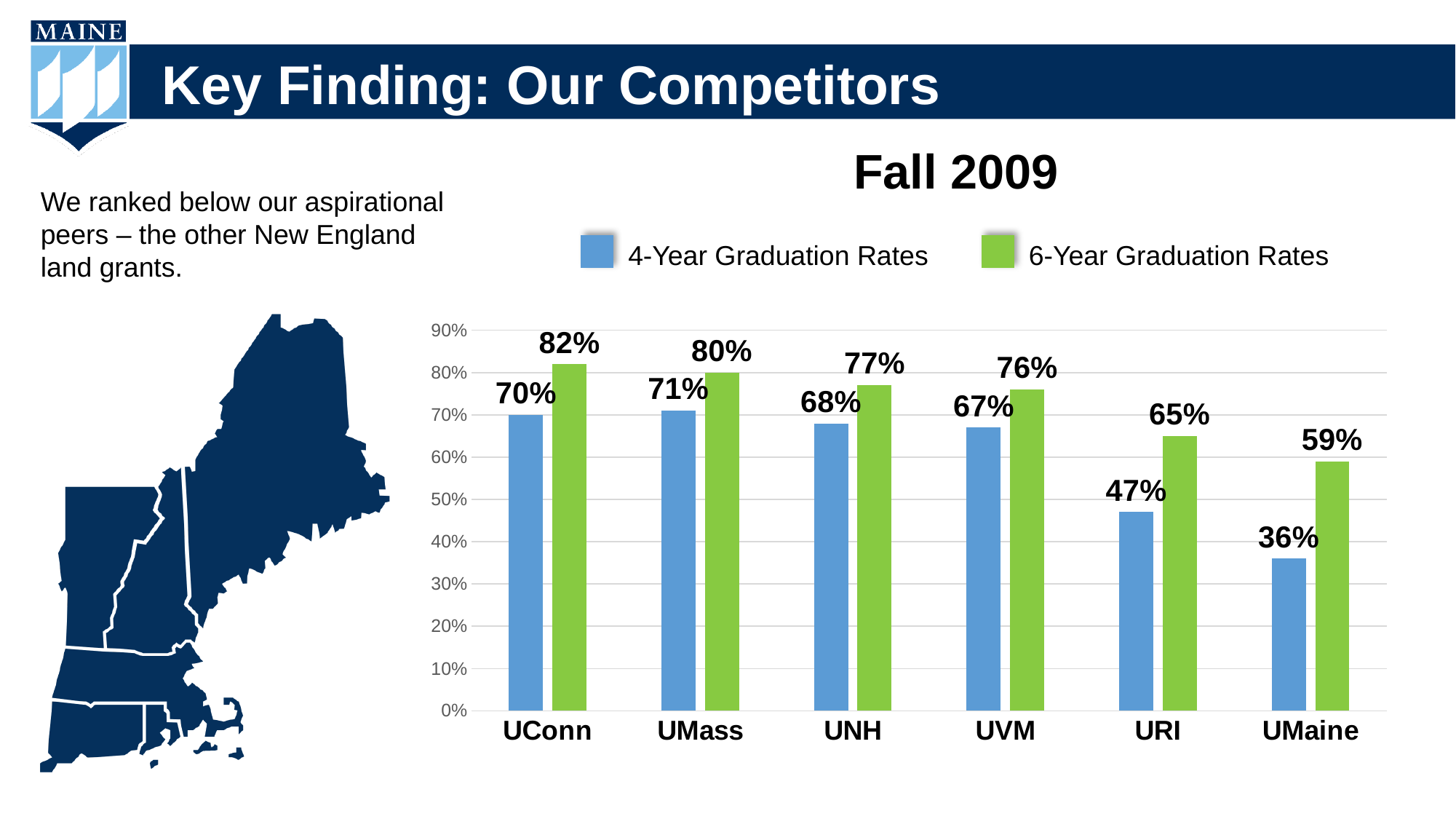
What is the 6-Year Graduation Rate for URI? 65% What is the 6-Year Graduation Rate for UConn? 82% How many series does the legend list? 2 What is the title shown above the chart? Fall 2009 Which is larger, the 6-Year Graduation Rate for UNH or for UVM? UNH Which university has the lowest 6-Year Graduation Rate? UMaine What is the difference between the 4-Year Graduation Rates of UConn and URI? 23% What is the 4-Year Graduation Rate for UMaine? 36% Which university has the highest 4-Year Graduation Rate? UMass How many universities are shown on the x axis of the chart? 6 What is the difference between the 6-Year and 4-Year Graduation Rates for UMaine? 23% What kind of chart is shown on the slide? Bar chart